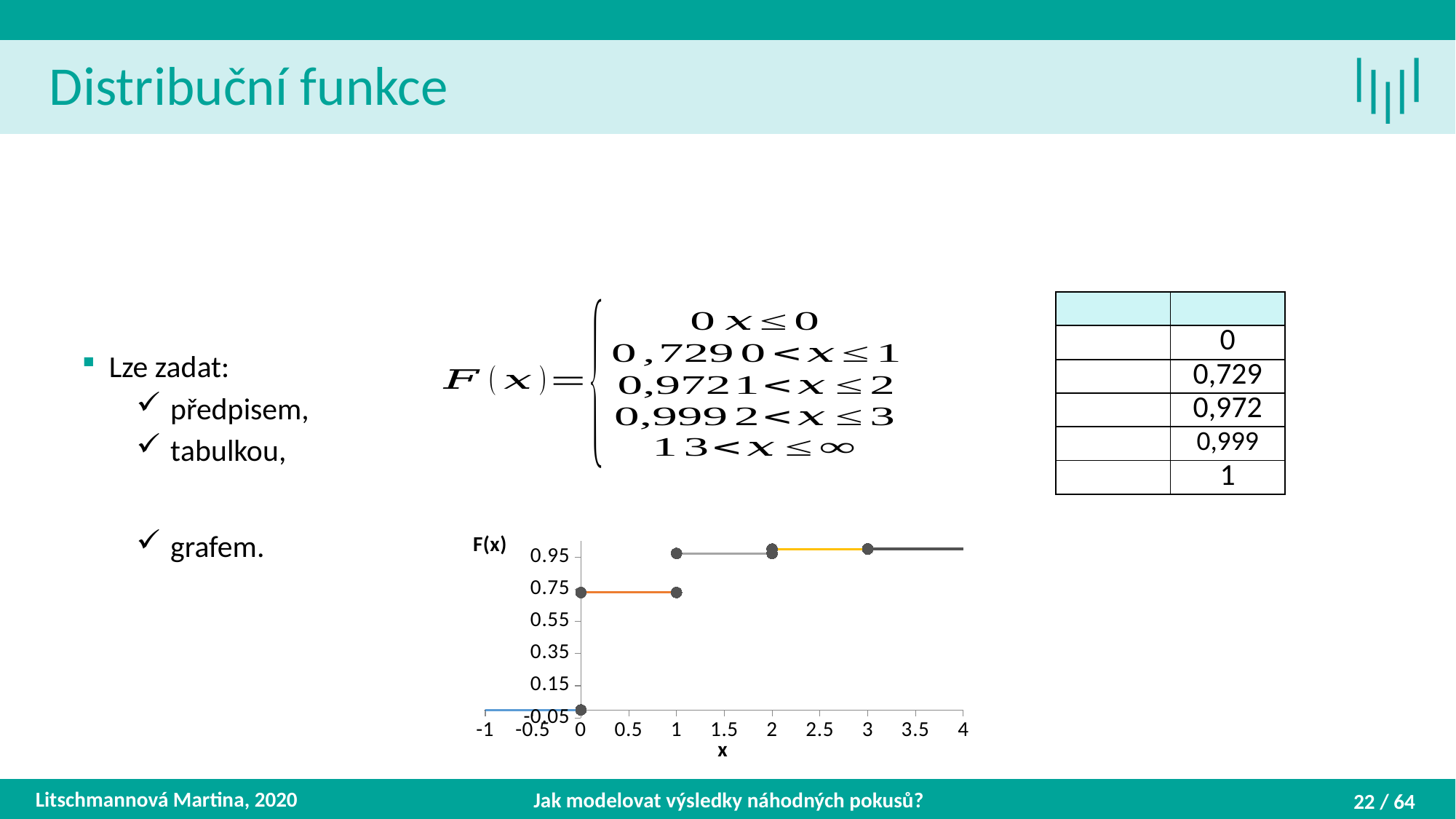
What kind of chart is shown on the slide? step (line) chart What is the highest tick label shown on the vertical axis of the chart? 0.95 Do the values of F(x) rise or fall as x increases along the horizontal axis? rise What is the label of the horizontal axis of the chart? x Is the value of F(x) at x = 3.5 greater or less than 0.75? greater What is the label of the vertical axis of the chart? F(x) Is the value of F(x) at x = 0.5 greater or less than 0.55? greater Is the value of F(x) at x = 0.5 greater or less than 0.95? less Which is larger: the value of F(x) at x = 0.5 or at x = 2.5? x = 2.5 How many tick labels are shown on the horizontal axis of the chart? 11